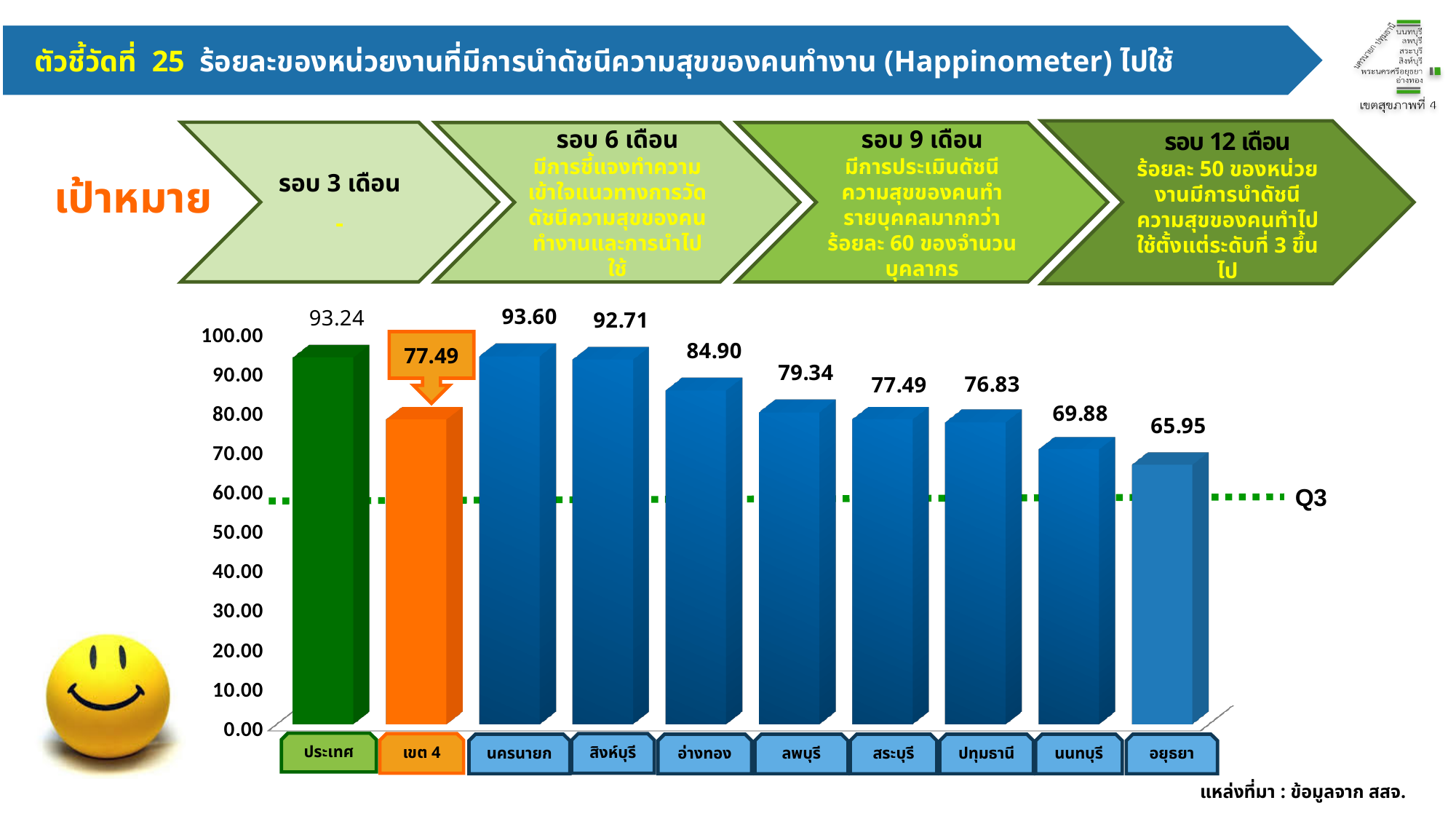
Which is larger, the value for อ่างทอง or the value for ลพบุรี? อ่างทอง Which category has the lowest value? อยุธยา What is the value for อยุธยา? 65.95 What kind of chart is shown on the slide? bar chart Which category has the highest value? นครนายก What is the value for นครนายก? 93.60 Is the value for นนทบุรี greater or less than 60.00? greater How many bars are shown in the chart? 10 What is the value for เขต 4? 77.49 What is the difference between the values for ประเทศ and เขต 4? 15.75 What is the difference between the values for นครนายก and อยุธยา? 27.65 What is the value for ประเทศ? 93.24